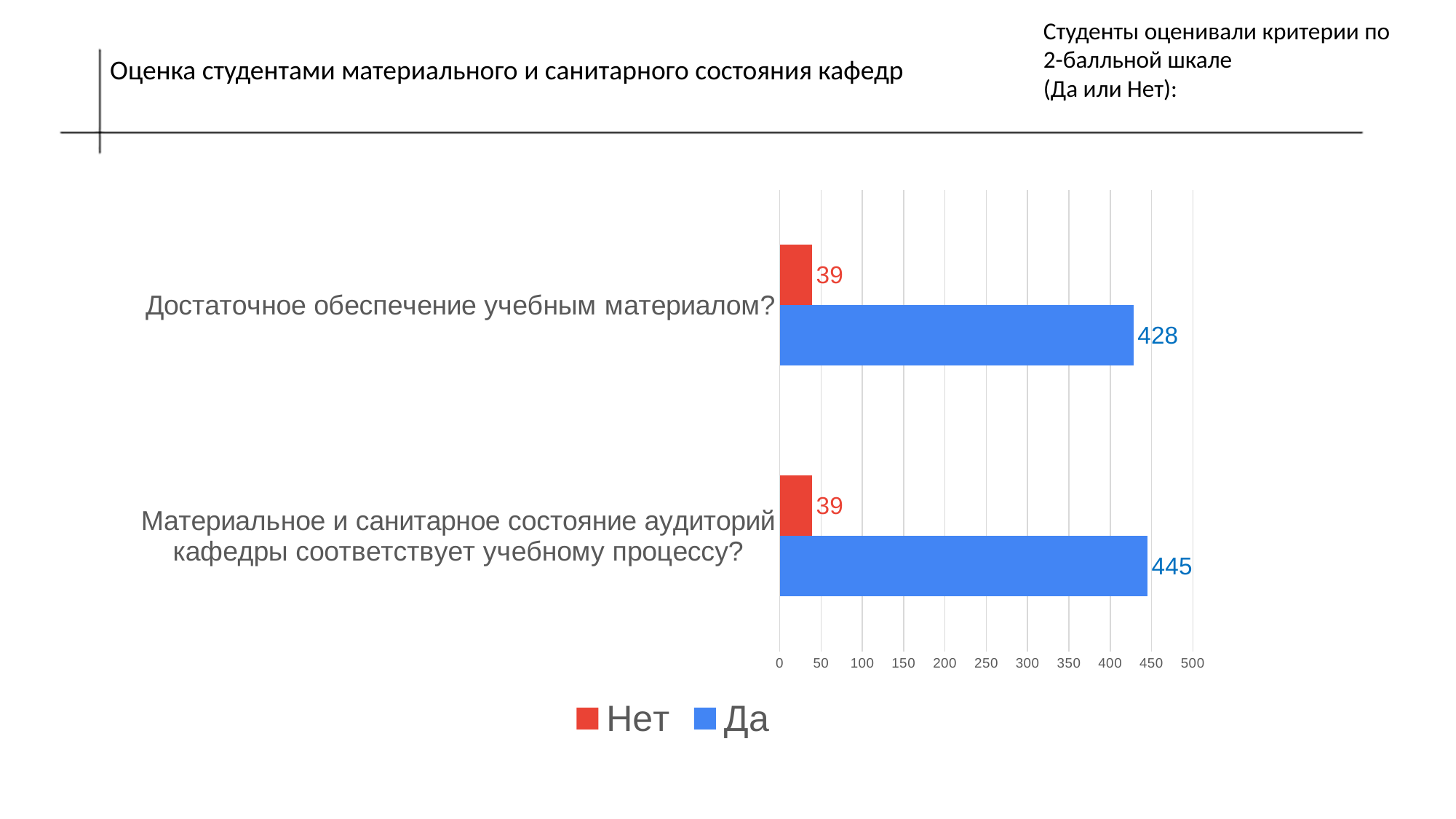
What is the "Да" value for "Достаточное обеспечение учебным материалом?"? 428 What is the difference between the "Да" values of the two categories? 17 How many series does the legend list? 2 For "Достаточное обеспечение учебным материалом?", what is the difference between the "Да" and "Нет" values? 389 What kind of chart is shown on the slide? bar chart Which category has the higher "Да" value? Материальное и санитарное состояние аудиторий кафедры соответствует учебному процессу? What is the "Нет" value for "Материальное и санитарное состояние аудиторий кафедры соответствует учебному процессу?"? 39 Is the "Да" value for "Достаточное обеспечение учебным материалом?" greater or less than 400? greater What is the "Да" value for "Материальное и санитарное состояние аудиторий кафедры соответствует учебному процессу?"? 445 How many categories are shown on the chart? 2 Which is larger for "Достаточное обеспечение учебным материалом?": the "Да" value or the "Нет" value? Да Which colour represents the "Нет" series? red